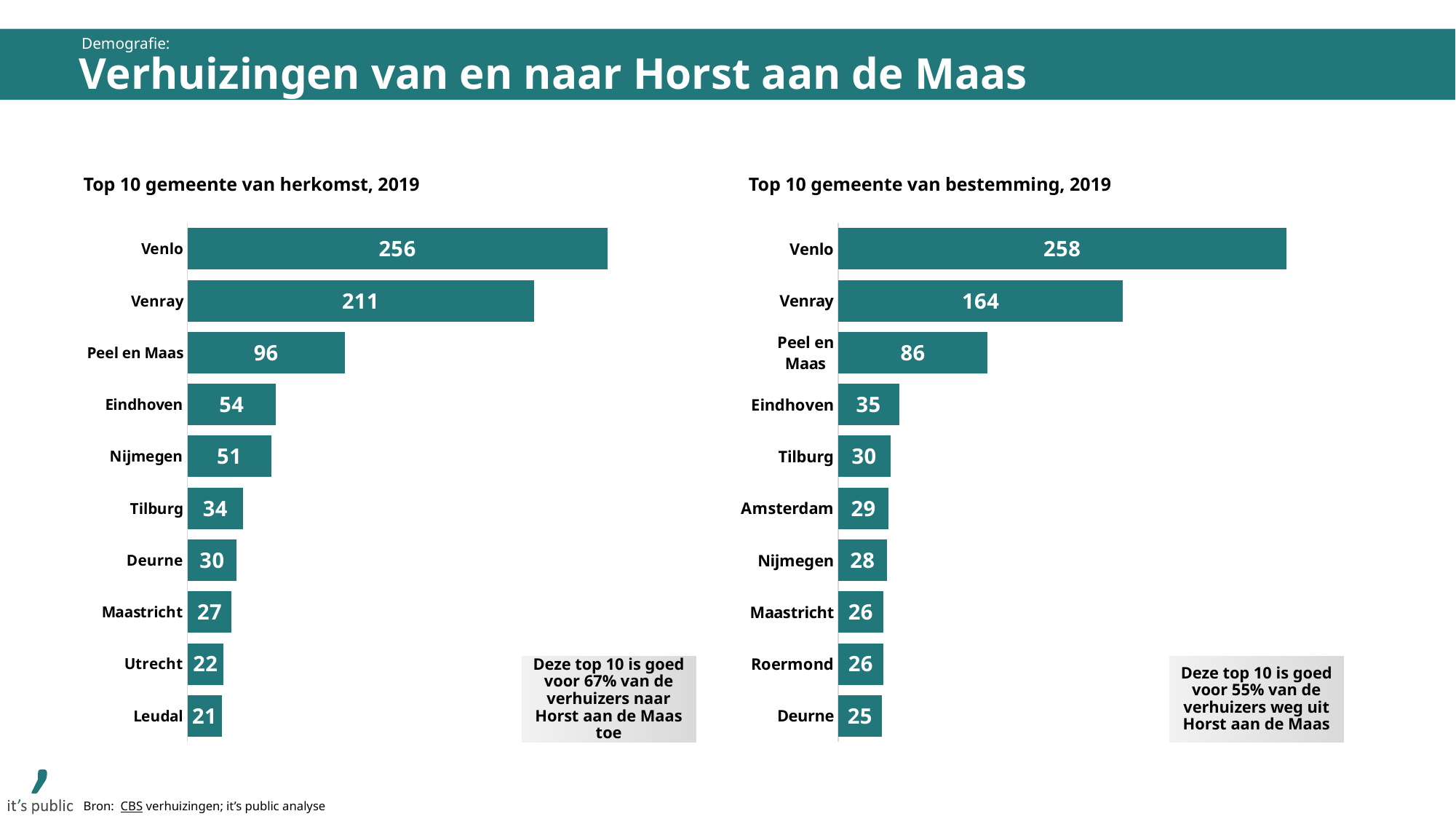
In the chart 'Top 10 gemeente van bestemming, 2019', which municipality has the lowest value? Deurne How many municipalities are shown in the chart 'Top 10 gemeente van herkomst, 2019'? 10 Which is larger: the value for Eindhoven in the 'Top 10 gemeente van herkomst, 2019' chart or the value for Eindhoven in the 'Top 10 gemeente van bestemming, 2019' chart? Top 10 gemeente van herkomst, 2019 In the chart 'Top 10 gemeente van herkomst, 2019', which municipality has the highest value? Venlo In the chart 'Top 10 gemeente van herkomst, 2019', what is the value for Venray? 211 In the chart 'Top 10 gemeente van bestemming, 2019', what is the value for Peel en Maas? 86 In the chart 'Top 10 gemeente van bestemming, 2019', what is the difference between the values for Venray and Eindhoven? 129 In the chart 'Top 10 gemeente van bestemming, 2019', which is larger: the value for Tilburg or the value for Deurne? Tilburg What kind of chart is 'Top 10 gemeente van bestemming, 2019'? Bar chart In the chart 'Top 10 gemeente van herkomst, 2019', what is the difference between the values for Venlo and Venray? 45 In the chart 'Top 10 gemeente van herkomst, 2019', what is the value for Leudal? 21 According to the text box next to the chart 'Top 10 gemeente van bestemming, 2019', what share of movers away from Horst aan de Maas does this top 10 account for? 55%